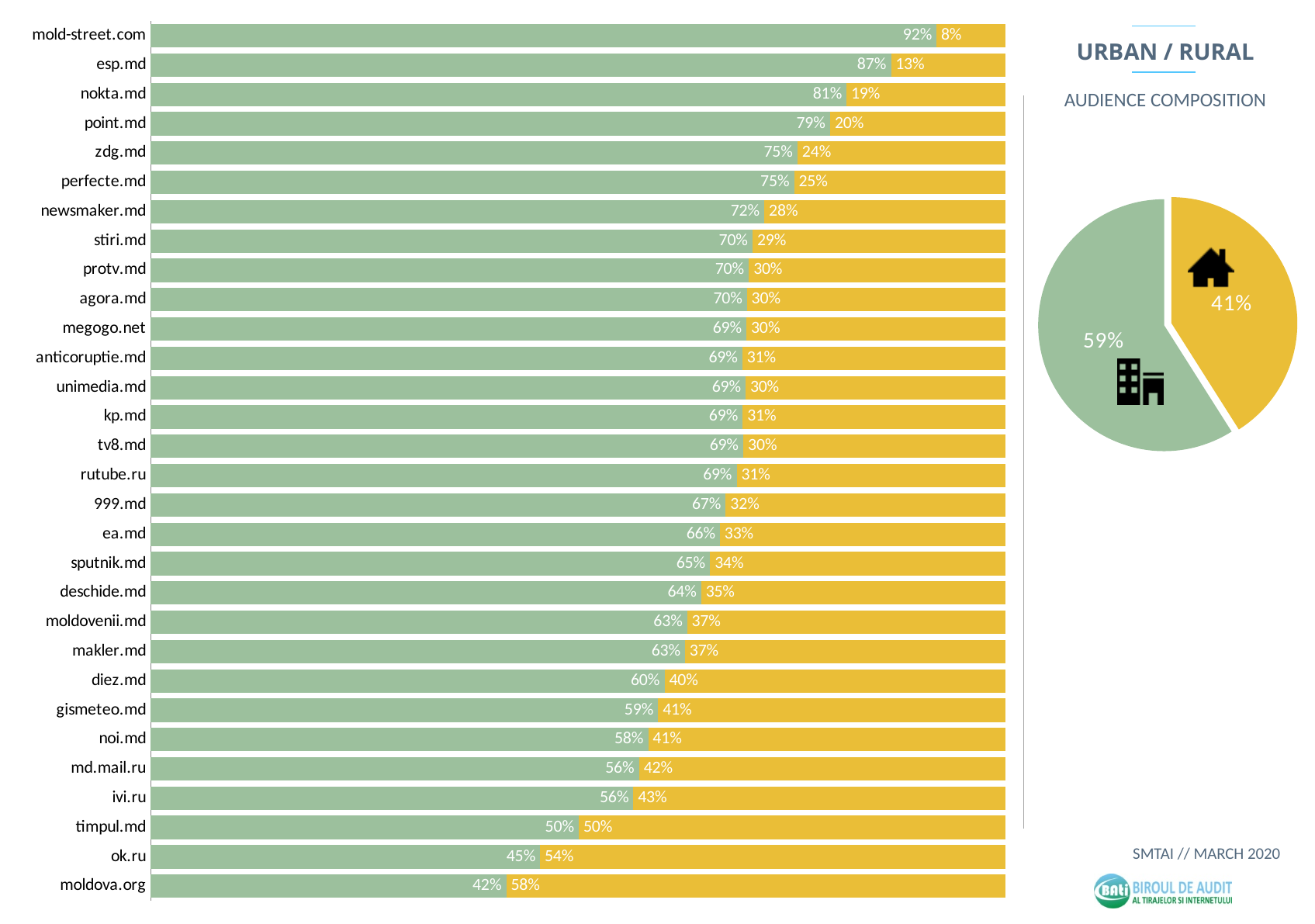
In the bar chart, which site has the lowest green segment value? moldova.org What type of chart is the chart on the left of the slide? bar chart How many sites are listed in the bar chart? 30 In the bar chart, what is the yellow segment value for moldova.org? 58% In the bar chart, which site has the highest green segment value? mold-street.com In the bar chart, what is the yellow segment value for newsmaker.md? 28% In the bar chart, what is the difference between the green segment values of esp.md and nokta.md? 6% In the pie chart, what is the share of the yellow slice? 41% In the bar chart, what is the green segment value for mold-street.com? 92% What is the title shown above the pie chart? URBAN / RURAL In the bar chart, which site has a larger yellow segment value, diez.md or ok.ru? ok.ru In the pie chart, what is the share of the green slice? 59%